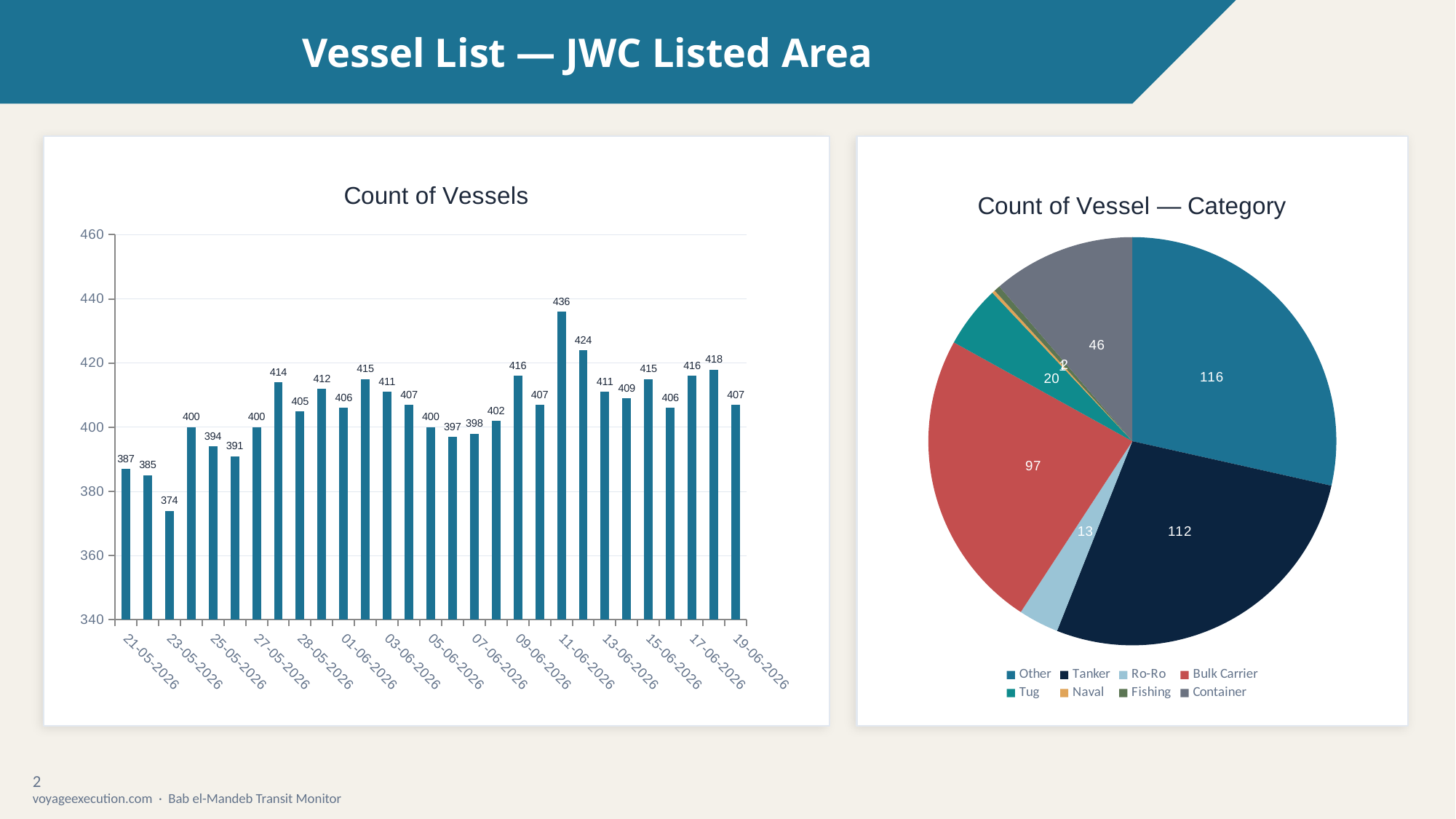
In the "Count of Vessels" chart, what is the count for 19-06-2026? 407 How many categories does the legend of the "Count of Vessel — Category" pie chart list? 8 In the "Count of Vessels" chart, what is the difference between the highest value (436) and the lowest value (374)? 62 In the "Count of Vessels" chart, which date has the highest count? 11-06-2026 In the "Count of Vessels" chart, which is larger: the count for 25-05-2026 or the count for 15-06-2026? 15-06-2026 In the "Count of Vessels" chart, what is the count for 21-05-2026? 387 In the "Count of Vessel — Category" pie chart, what is the difference between Other (116) and Tanker (112)? 4 In the "Count of Vessels" chart, which date has the lowest count? 23-05-2026 In the "Count of Vessels" chart, what is the highest value shown? 436 What kind of chart is the "Count of Vessels" chart on the left? Bar chart In the "Count of Vessel — Category" pie chart, what is the value for Other? 116 In the "Count of Vessel — Category" pie chart, what is the value for Bulk Carrier? 97